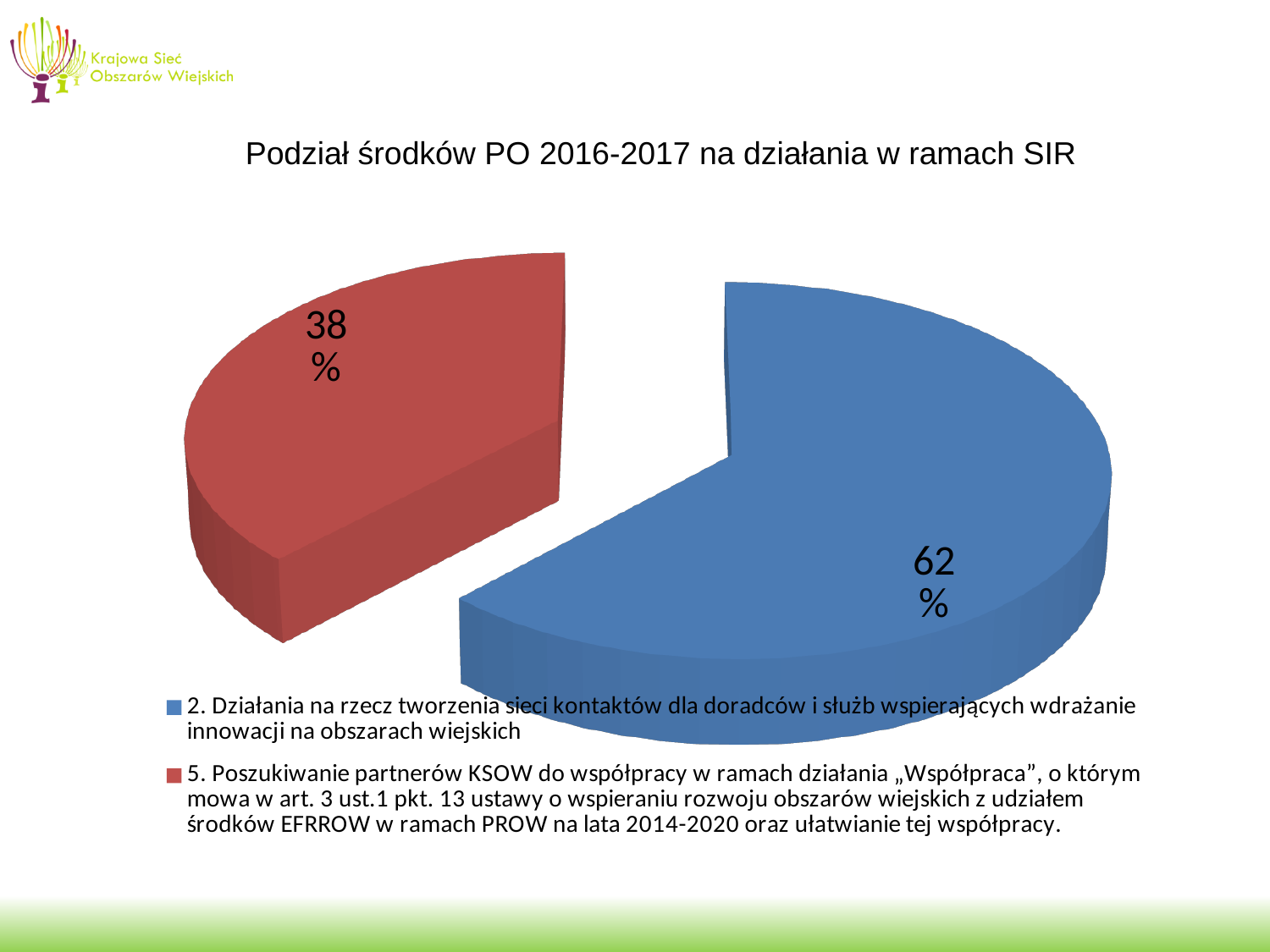
What is the value shown on the red slice of the pie? 38% What share of the pie is labelled for the slice "5. Poszukiwanie partnerów KSOW do współpracy w ramach działania „Współpraca”..."? 38% Which slice is larger: the one for action 2 (sieci kontaktów dla doradców) or the one for action 5 (poszukiwanie partnerów KSOW)? Action 2 (sieci kontaktów dla doradców) What colour is the slice labelled 62%? Blue Which legend entry corresponds to the largest slice of the pie? 2. Działania na rzecz tworzenia sieci kontaktów dla doradców i służb wspierających wdrażanie innowacji na obszarach wiejskich How many slices does the pie chart have? 2 What type of chart is shown on the slide? Pie chart What is the title of the chart? Podział środków PO 2016-2017 na działania w ramach SIR What is the difference in percentage points between the 62% slice and the 38% slice? 24 percentage points How many entries does the legend list? 2 What share of the pie is labelled for the slice "2. Działania na rzecz tworzenia sieci kontaktów dla doradców i służb wspierających wdrażanie innowacji na obszarach wiejskich"? 62%